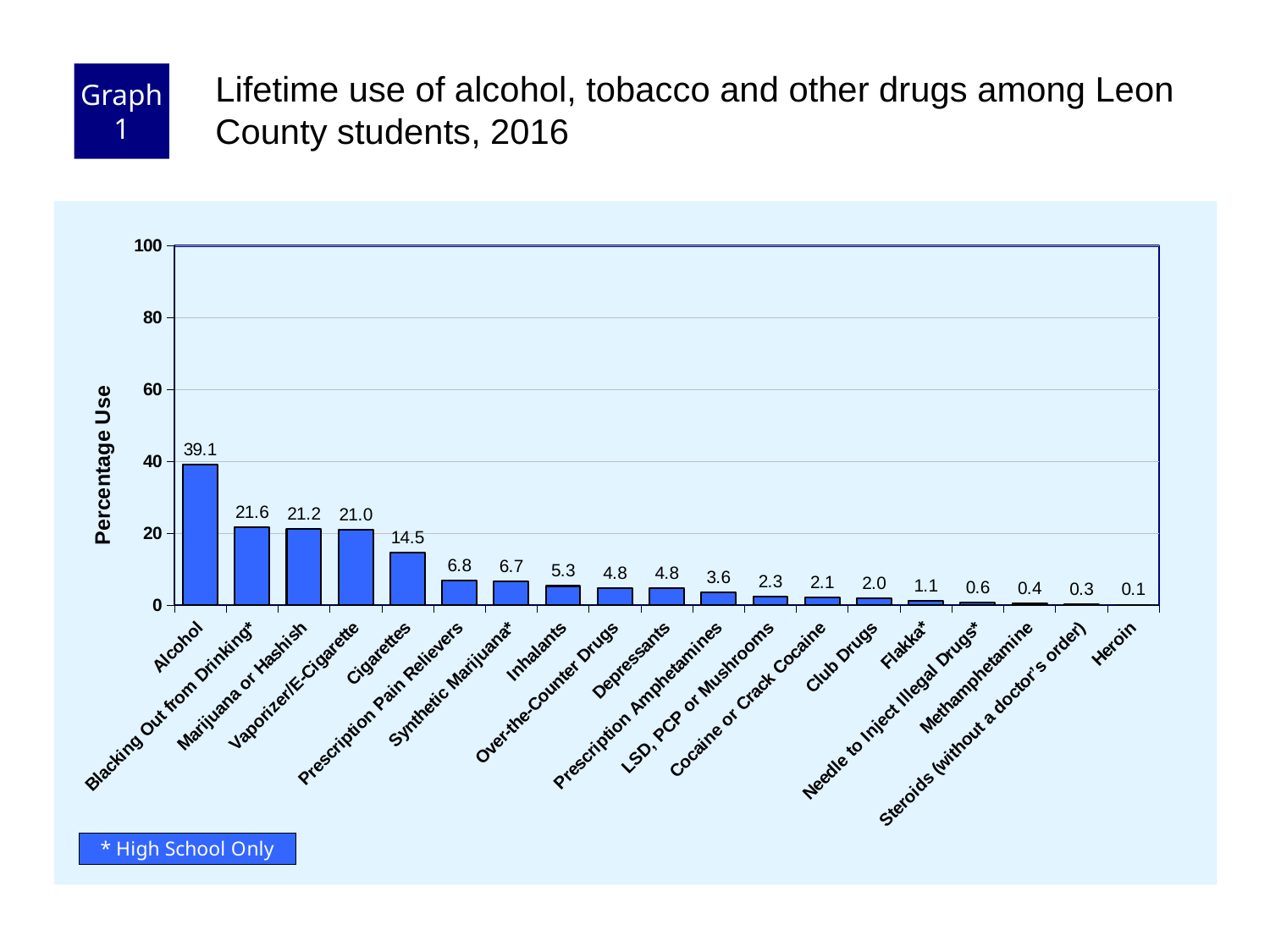
What is the percentage use for Flakka*? 1.1 What is the percentage use for Cigarettes? 14.5 What is the difference in percentage use between Alcohol and Blacking Out from Drinking*? 17.5 What is the percentage use for Alcohol? 39.1 Which category has the lowest percentage use? Heroin Which has a higher percentage use, Cigarettes or Prescription Pain Relievers? Cigarettes What is the label of the y axis? Percentage Use What is the percentage use for Inhalants? 5.3 What kind of chart is shown on the slide? Bar chart Is the value for Alcohol greater or less than 20? greater Which category has the highest percentage use? Alcohol How many categories are shown on the x axis? 19